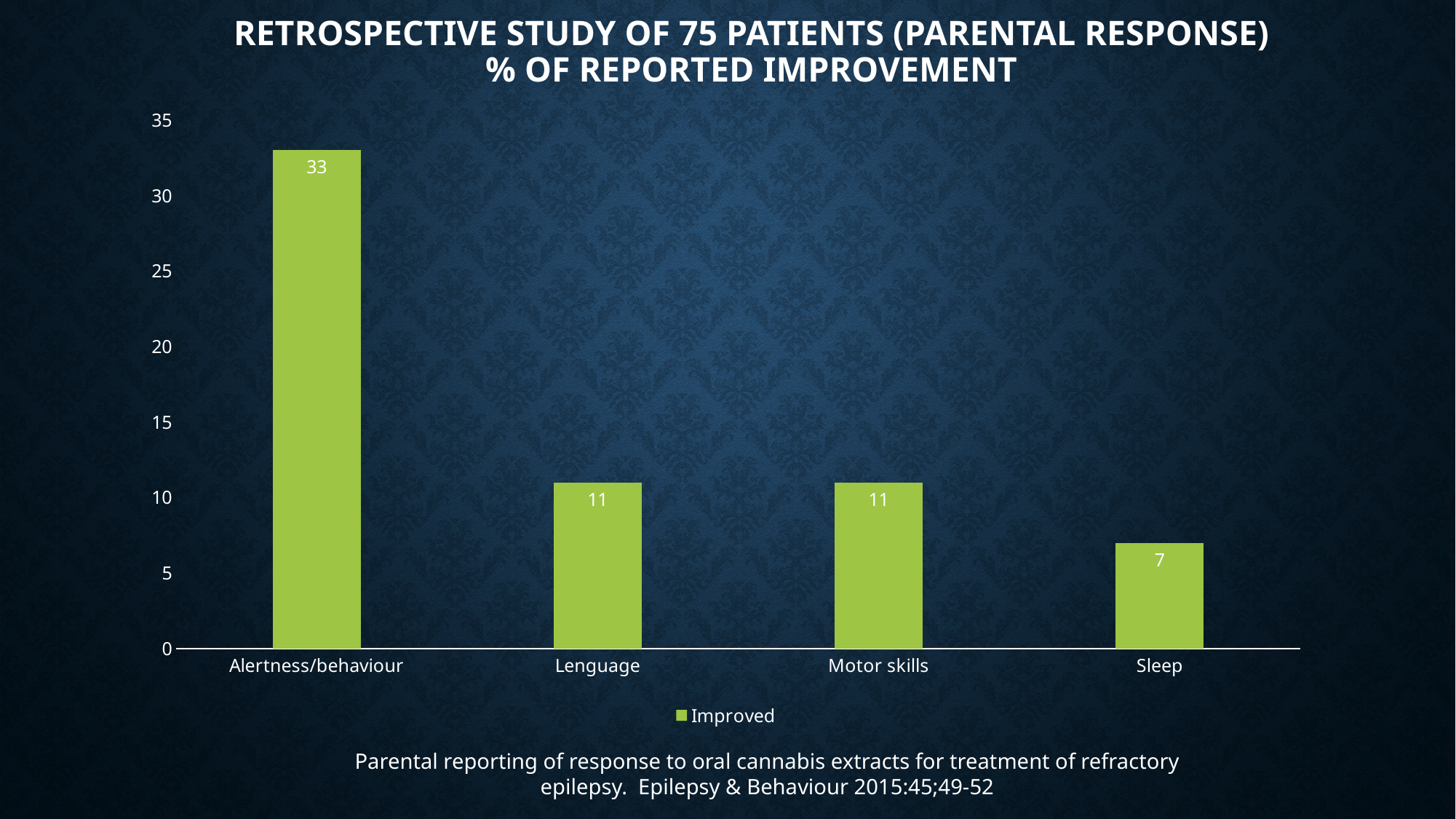
What is the difference between the values for Lenguage and Sleep? 4 What is the value for Motor skills? 11 Is the value for Alertness/behaviour greater or less than 30? greater Which is larger, the value for Motor skills or the value for Sleep? Motor skills How many series does the legend list? 1 What is the value for Alertness/behaviour? 33 Which category has the lowest value? Sleep What is the difference between the values for Alertness/behaviour and Sleep? 26 Which category has the highest value? Alertness/behaviour How many categories are shown on the x axis? 4 What is the value for Sleep? 7 What kind of chart is shown on the slide? bar chart